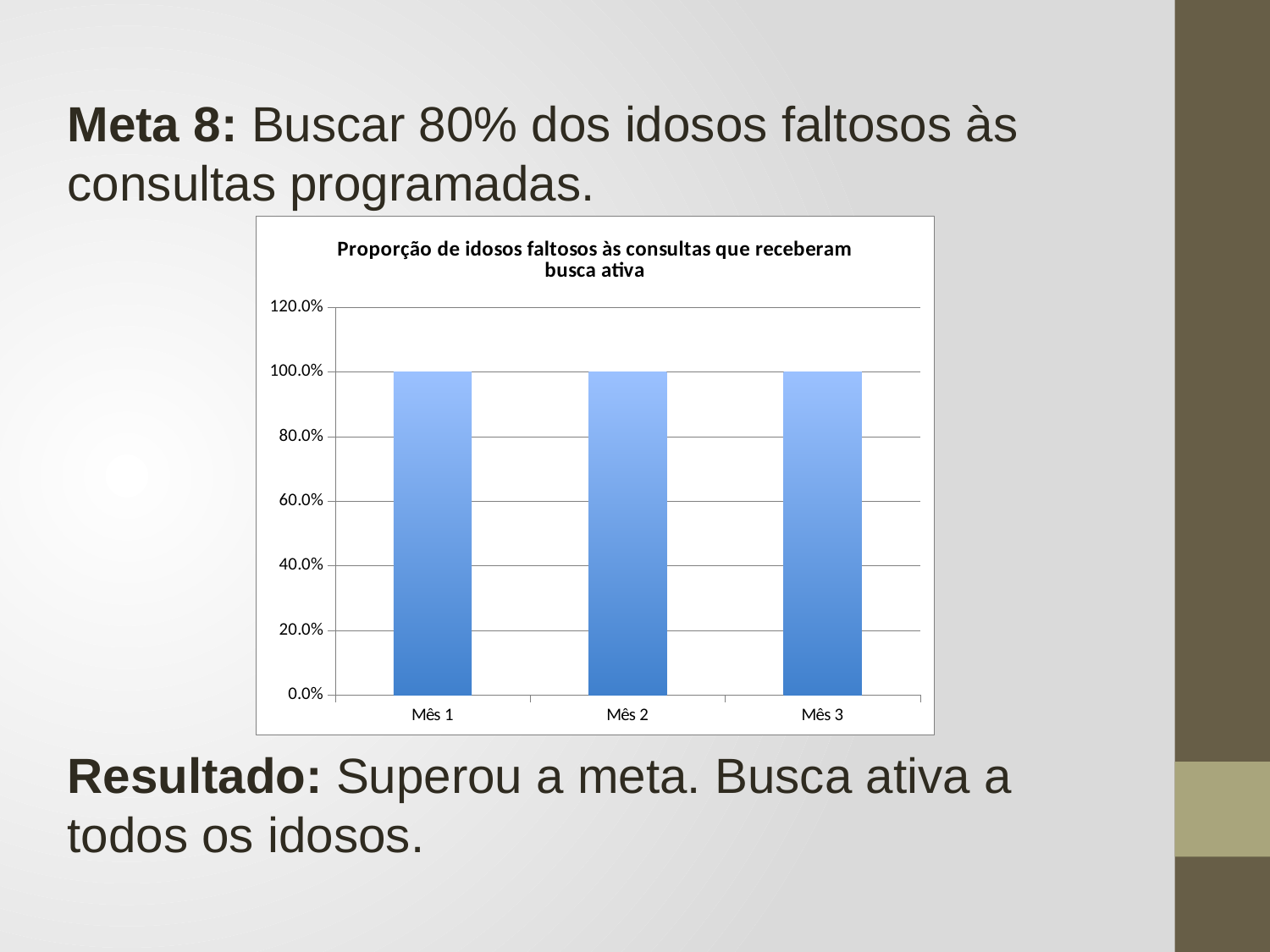
What is the highest value shown on the vertical axis? 120.0% How many categories (months) are plotted on the chart? 3 What is the title of the chart? Proporção de idosos faltosos às consultas que receberam busca ativa What type of chart is shown on the slide? Bar chart What is the difference between the values for Mês 1 and Mês 2? 0.0% What is the value for Mês 1? 100.0% Is the value for Mês 1 greater or less than 80.0%? greater Is the value for Mês 3 greater or less than 120.0%? less Do the values rise, fall, or stay the same from Mês 1 to Mês 3? Stay the same What is the value for Mês 3? 100.0% What is the value for Mês 2? 100.0%